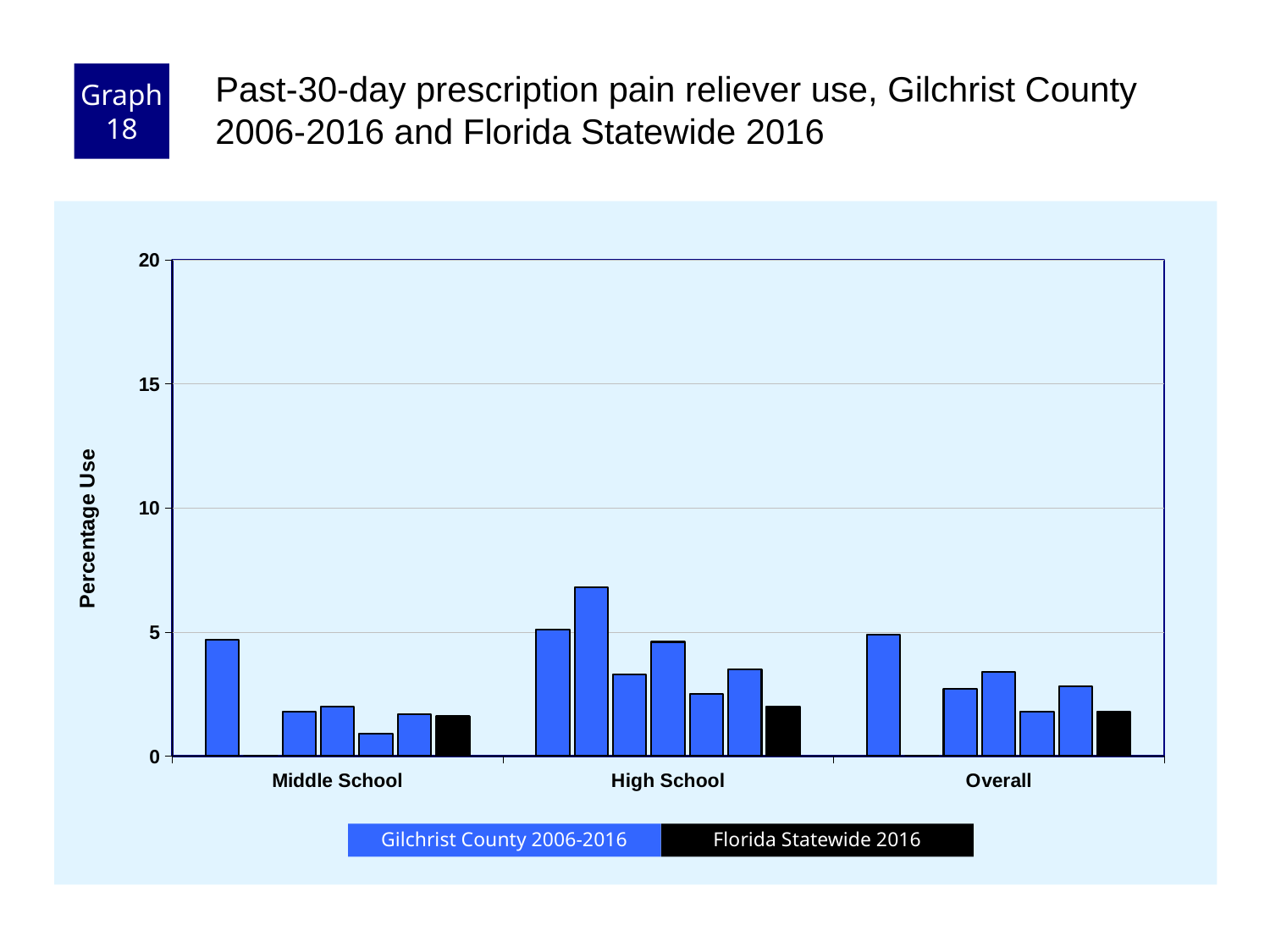
Is the Florida Statewide 2016 value for Overall greater or less than 5? less Which category contains the tallest bar in the chart? High School Is any bar in the chart greater than 10? no Which colour represents the Florida Statewide 2016 series? black How many categories are shown on the x axis? 3 How many series does the legend list? 2 What is the title of the y axis? Percentage Use Is the tallest bar in the High School category greater or less than 5? greater Which is larger: the first Gilchrist County bar in the Middle School category or the Florida Statewide 2016 bar in the Middle School category? the first Gilchrist County bar What kind of chart is shown on the slide? bar chart Which is larger: the Florida Statewide 2016 bar for High School or the tallest Gilchrist County bar for High School? the tallest Gilchrist County bar